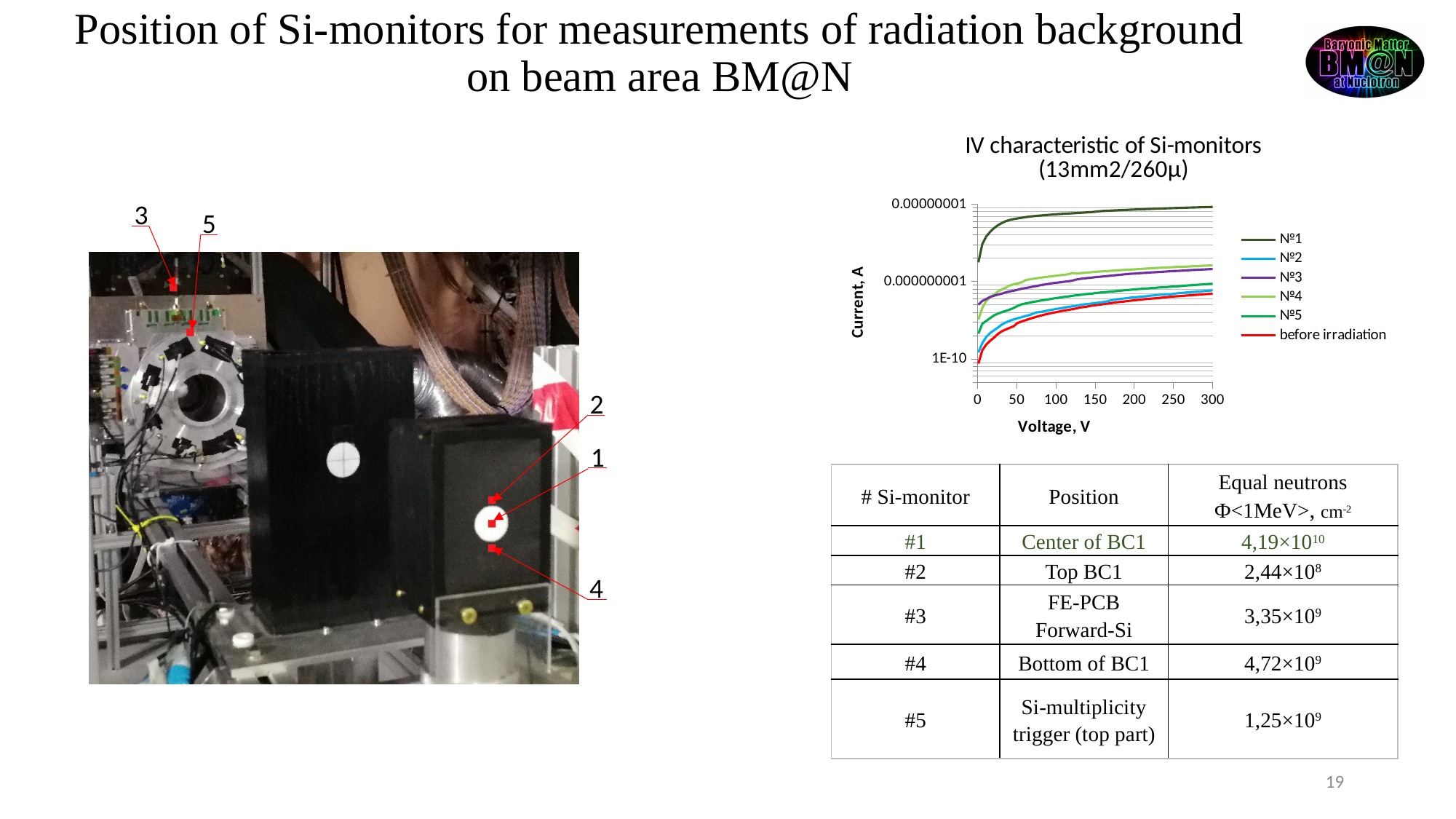
At 300 V, is the current for №2 greater or less than 0.000000001 A? less At 300 V, is the current for the 'before irradiation' series greater or less than 0.000000001 A? less What kind of chart is shown on the slide? line chart At 300 V, is the current for №4 greater or less than 0.000000001 A? greater How many series does the legend of the IV characteristic chart list? 6 Which series has the larger current at 300 V, №1 or №2? №1 Which series has the highest current across the voltage range in the IV characteristic chart? №1 Does the current rise or fall as voltage increases in the IV characteristic chart? rise What is the label of the x axis of the IV characteristic chart? Voltage, V Which series has the lowest current across the voltage range in the IV characteristic chart? before irradiation Which series has the larger current at 300 V, №4 or №2? №4